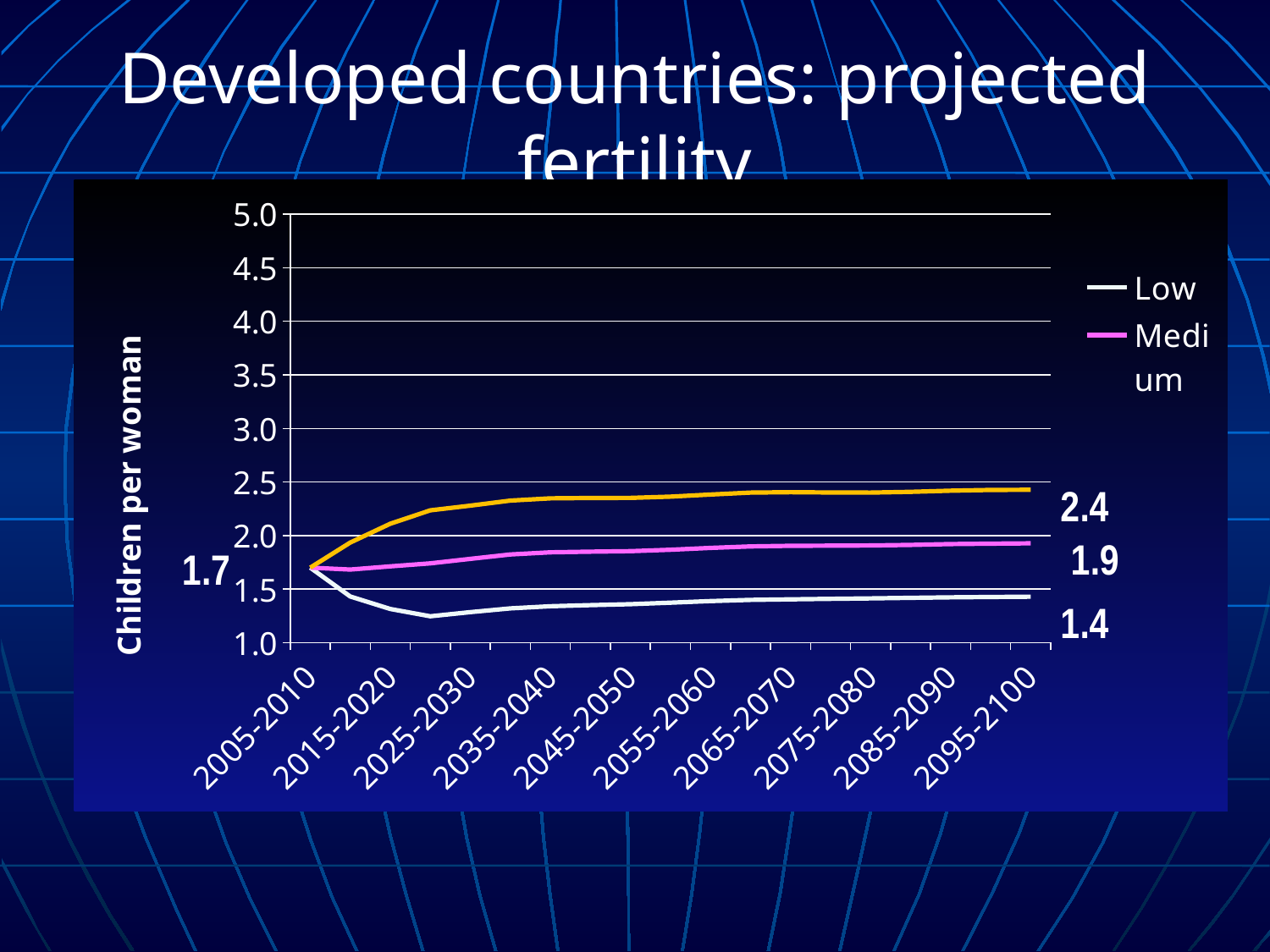
What value is labelled for the Medium series at 2095-2100? 1.9 Is the value of the top (orange) line at 2045-2050 greater or less than 2.0? greater At 2095-2100, which series has the larger value, Low or Medium? Medium What value is labelled for the top (orange) line at 2095-2100? 2.4 By how much does the Medium series' labelled value at 2095-2100 exceed the starting value of 1.7 at 2005-2010? 0.2 Does the Low series rise or fall between 2025-2030 and 2095-2100? rises What value is labelled for the Low series at 2095-2100? 1.4 What is the title of the vertical axis? Children per woman What is the difference between the top line's labelled value (2.4) and the Low series' labelled value (1.4) at 2095-2100? 1.0 What is the fertility value labelled at the start of the chart, for 2005-2010? 1.7 Is the value of the Low series at 2025-2030 greater or less than 1.5? less What kind of chart is shown on the slide? line chart